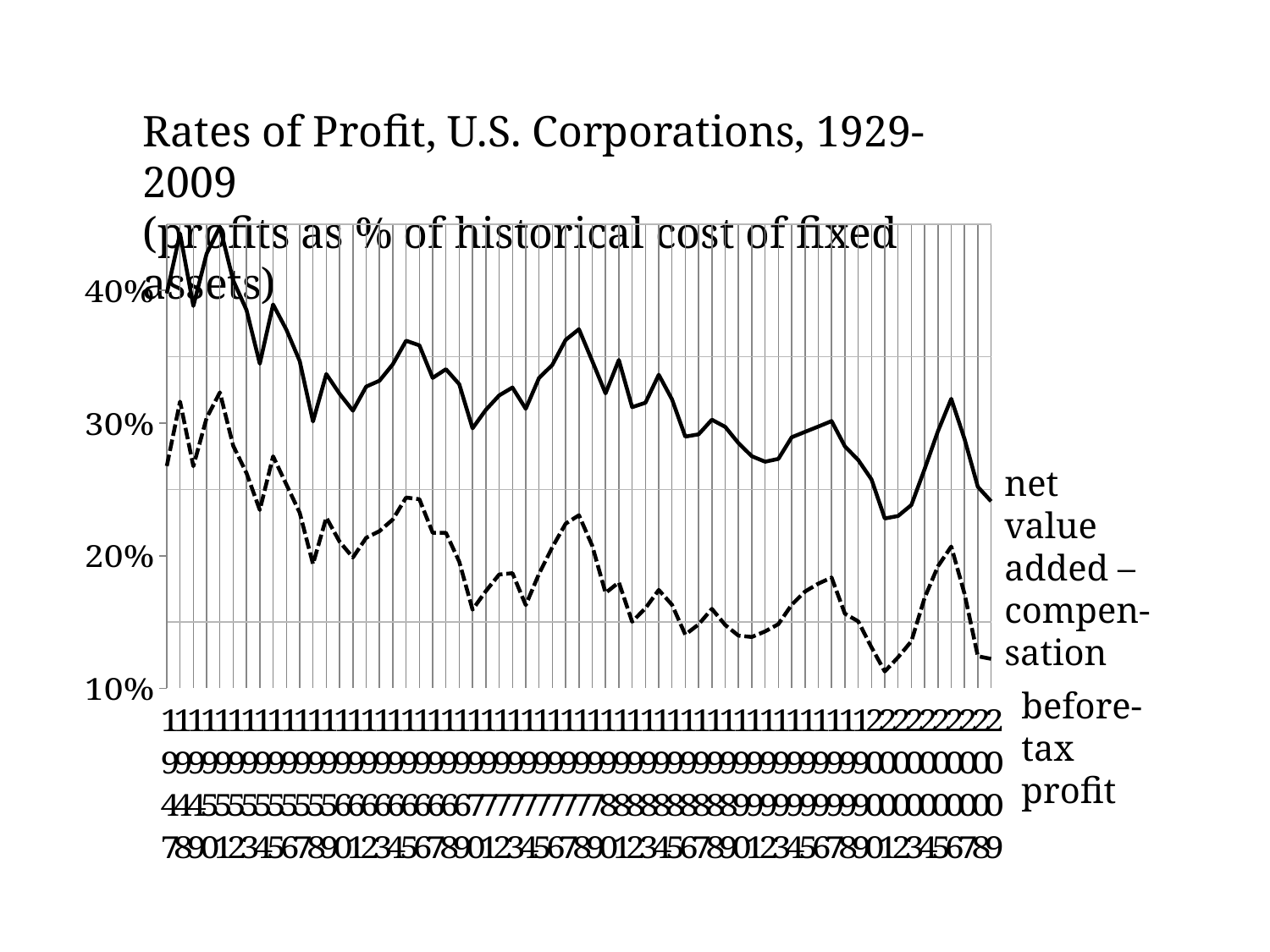
How many series does the chart plot? 2 Is the value of the 'net value added – compensation' series in 2009 greater or less than 20%? greater What is the title of the chart? Rates of Profit, U.S. Corporations, 1929-2009 (profits as % of historical cost of fixed assets) What is the first year shown on the x axis? 1947 For the 'net value added – compensation' series, which year has the higher value, 1966 or 2001? 1966 Is the value of the 'before-tax profit' series in 1947 greater or less than 20%? greater Overall, do the values of the 'before-tax profit' series rise or fall from 1947 to 2009? fall What kind of chart is shown on the slide? line chart Is the value of the 'before-tax profit' series in 2009 greater or less than 20%? less Which series has the higher value in 1980, 'net value added – compensation' or 'before-tax profit'? net value added – compensation